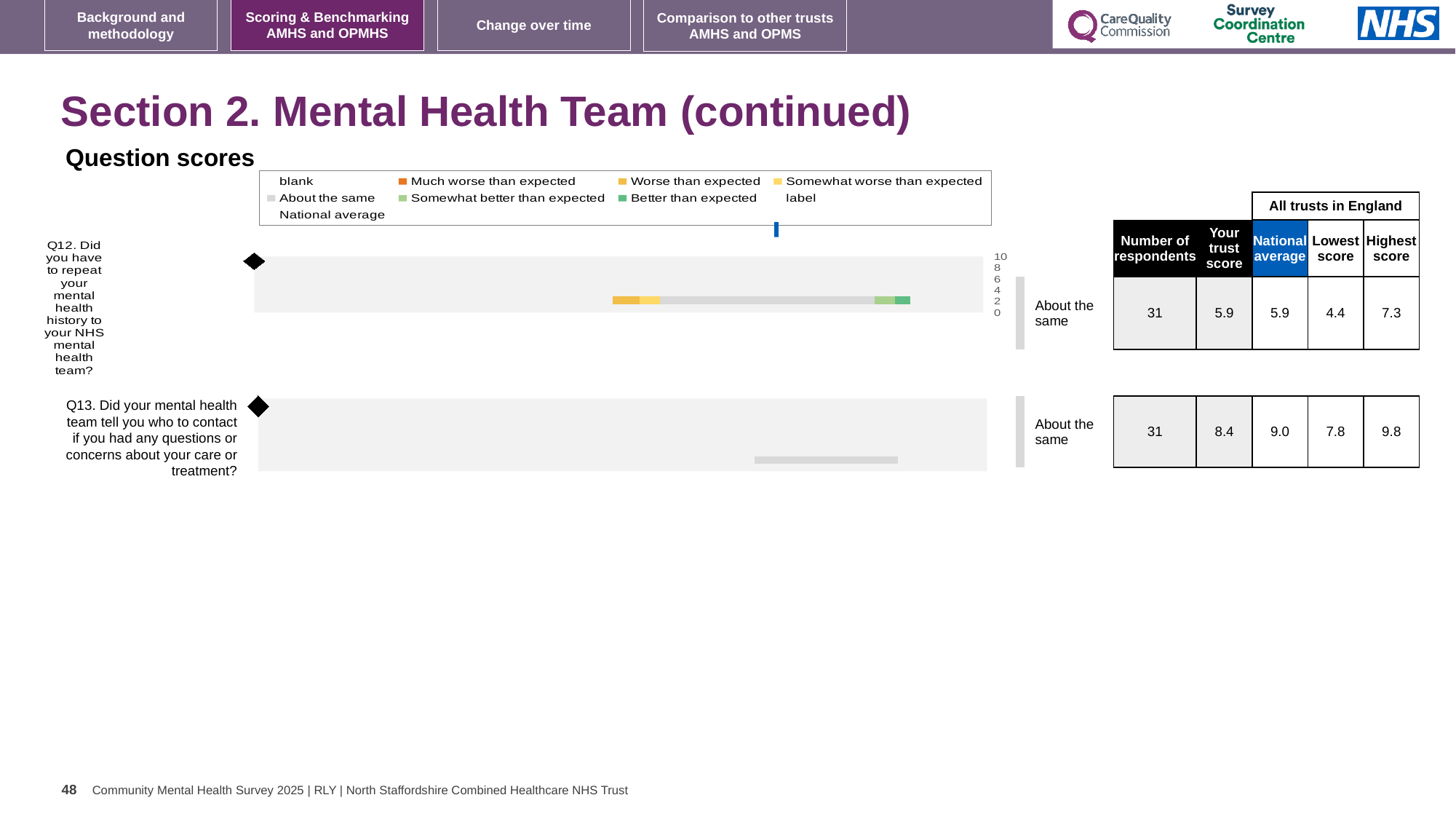
For Q12 (repeating your mental health history), what is the trust's score shown in the table? 5.9 How many respondents answered Q12? 31 What benchmark category is shown next to the Q13 chart? About the same For Q13, what is the highest score among all trusts in England? 9.8 For Q13, what is the difference between the highest score (9.8) and the lowest score (7.8)? 2.0 What kind of chart is used to show the Q12 benchmark on this slide? bar chart For Q13, what is the national average score? 9.0 How many questions (Q12 and Q13) have a chart on this slide? 2 For Q13 (who to contact with questions or concerns), what is the trust's score? 8.4 For Q12, what is the national average score? 5.9 For Q13, which is larger: the trust's score or the national average? national average For Q12, what is the lowest score among all trusts in England? 4.4